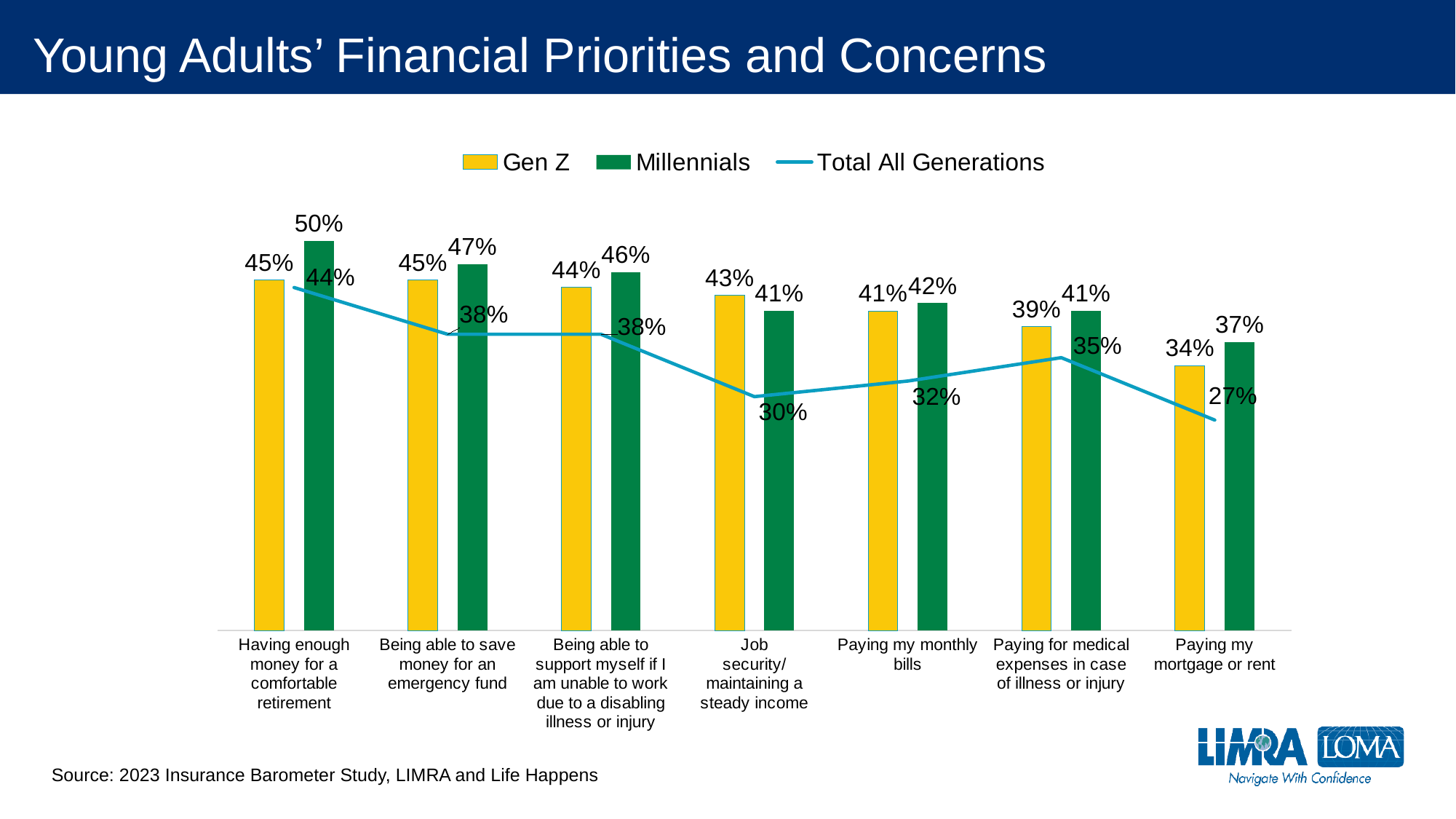
Which series is represented by the line in the chart? Total All Generations What is the difference between the Millennials value and the Total All Generations value for "Paying my mortgage or rent"? 10% What is the Gen Z value for "Paying my mortgage or rent"? 34% What is the difference between the Millennials and Gen Z values for "Being able to save money for an emergency fund"? 2% Which category has the lowest Gen Z value? Paying my mortgage or rent What is the Millennials value for "Having enough money for a comfortable retirement"? 50% What kind of chart is shown on the slide? Bar chart with a line What is the Total All Generations value for "Job security/maintaining a steady income"? 30% Which category has the highest Millennials value? Having enough money for a comfortable retirement For "Job security/maintaining a steady income", which is larger: the Gen Z value or the Millennials value? Gen Z How many categories are shown on the x axis? 7 How many series does the legend list? 3